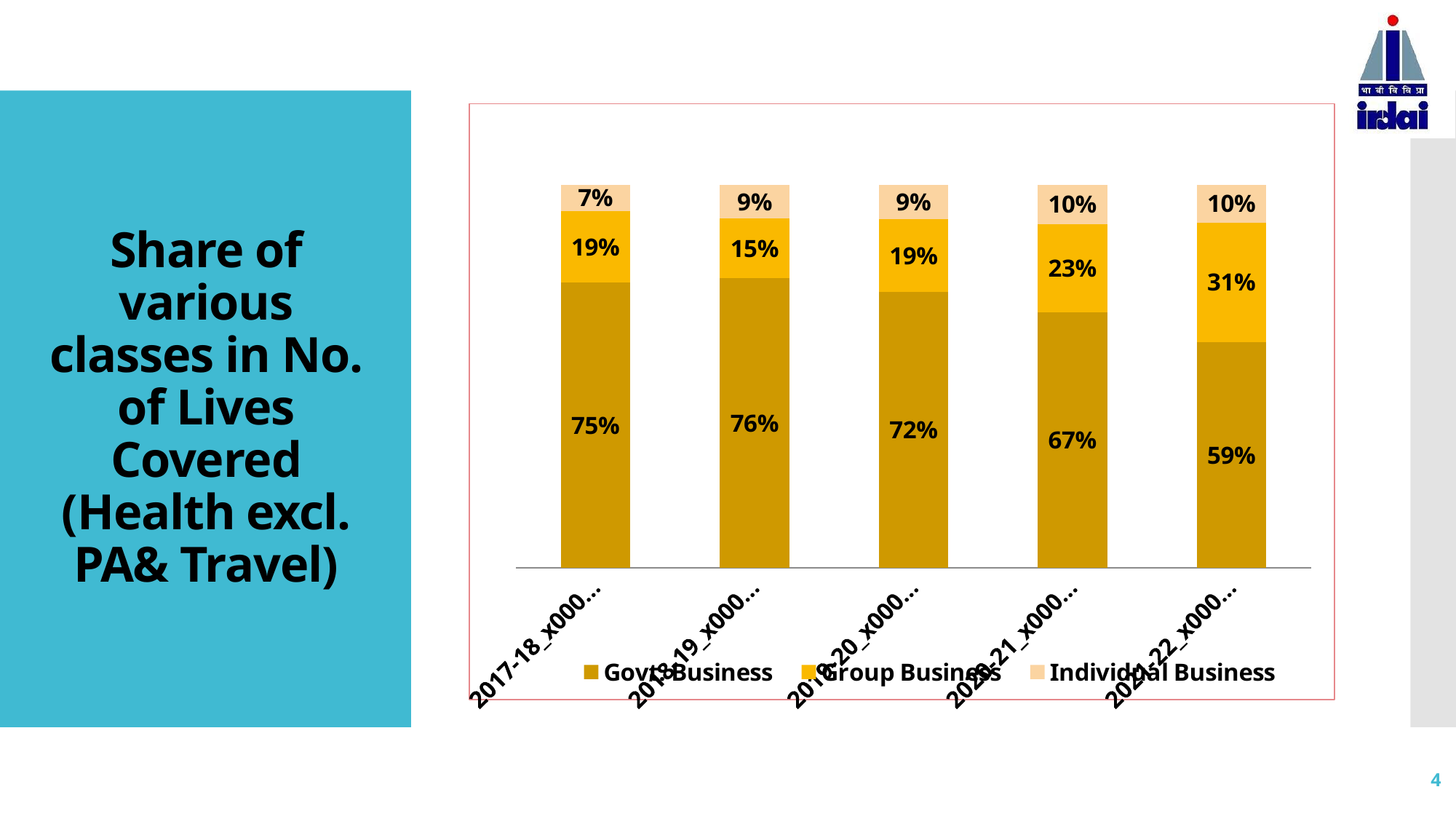
Which year has the lowest Govt Business share? 2021-22 What is the difference between the Govt Business share in 2017-18 and in 2021-22? 16% What is the Individual Business share for 2017-18? 7% What is the Govt Business share for 2017-18? 75% How many series does the legend list? 3 What is the Govt Business share in the fourth bar (2020-21)? 67% Does the Govt Business share rise or fall from 2019-20 to 2021-22? fall How many bars (years) are plotted in the chart? 5 What is the Group Business share for 2021-22? 31% Which year has the highest Group Business share? 2021-22 What type of chart is shown on the slide? stacked bar chart Which series is shown in the lightest (peach) colour in the legend? Individual Business